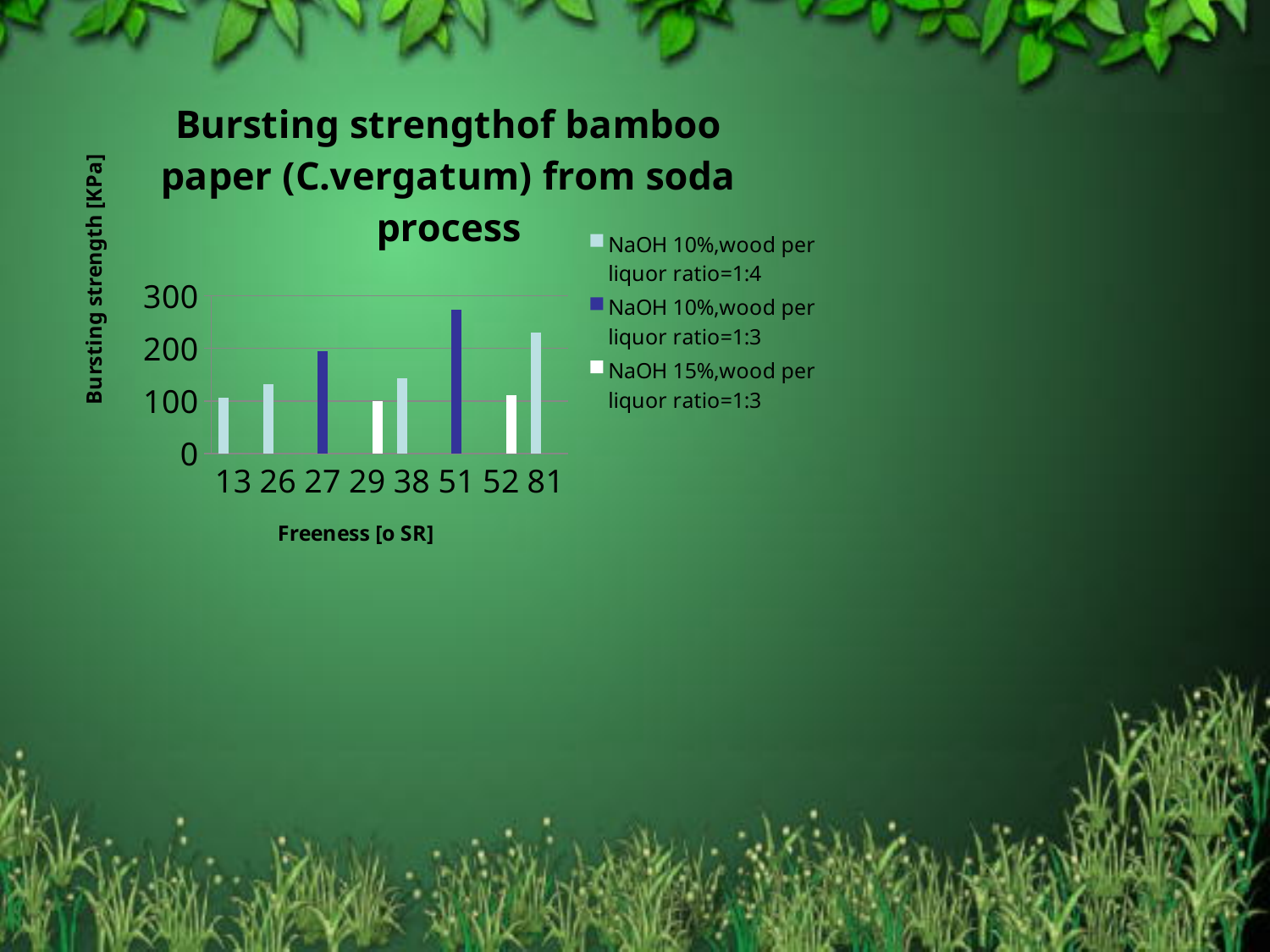
How many series does the legend list? 3 What is the title of the y axis? Bursting strength [KPa] Which has the larger bursting strength, freeness 27 or freeness 13? 27 Is the bursting strength at freeness 13 greater or less than 200? less Which freeness value has the highest bursting strength? 51 What is the title of the x axis? Freeness [o SR] Is the bursting strength at freeness 26 greater or less than 100? greater Which has the larger bursting strength, freeness 51 or freeness 81? 51 What kind of chart is shown on the slide? bar chart Is the bursting strength at freeness 51 greater or less than 200? greater How many freeness categories are shown on the x axis? 8